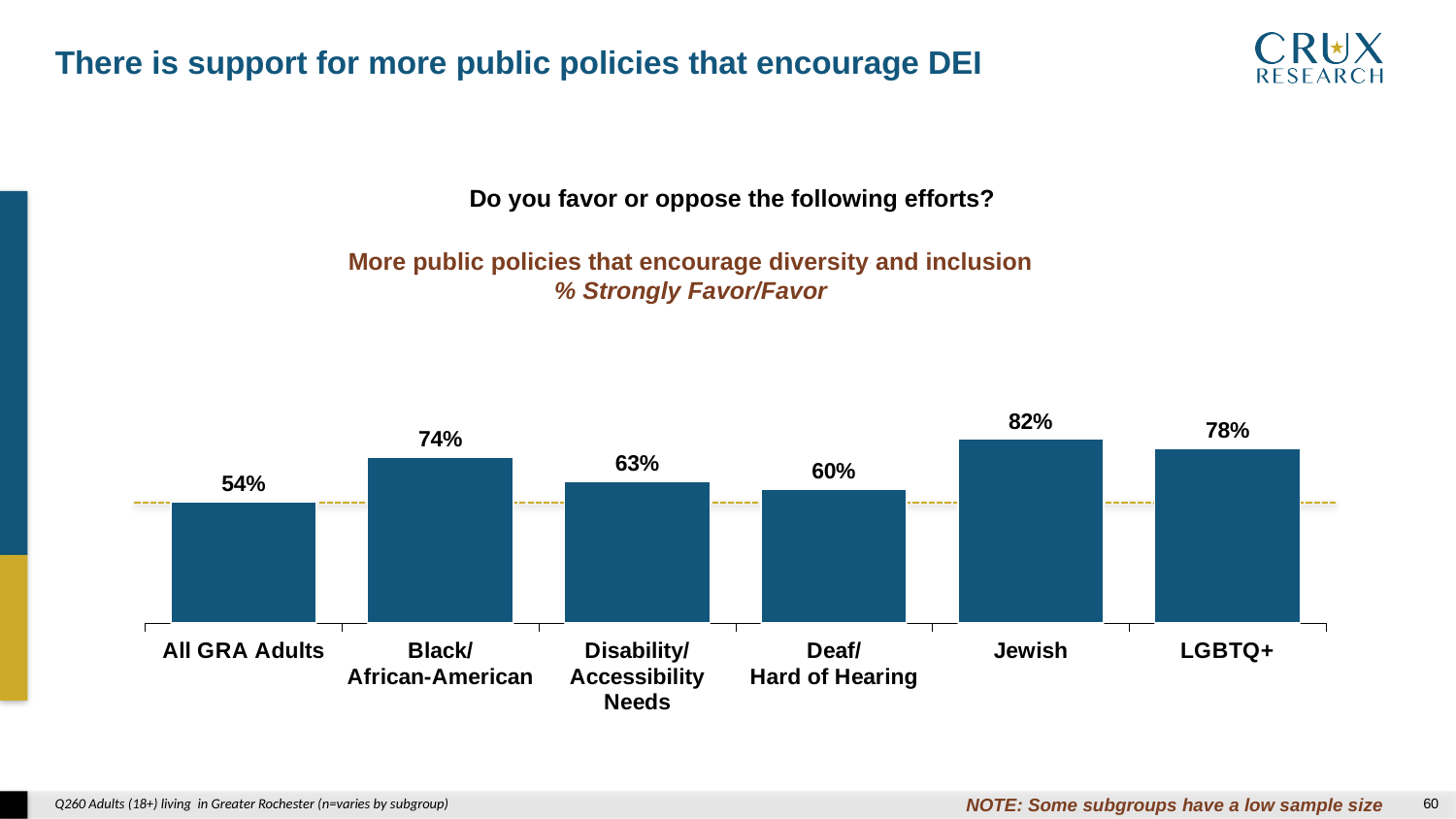
What percentage of All GRA Adults strongly favor/favor more public policies that encourage diversity and inclusion? 54% How many categories are shown on the chart? 6 What is the difference between the Black/African-American value and the All GRA Adults value? 20 percentage points What is the value shown for the Jewish subgroup? 82% Which subgroup has the highest percentage of strongly favor/favor? Jewish What is the value for the LGBTQ+ subgroup? 78% What is the difference between the Jewish and LGBTQ+ values? 4 percentage points What is the subtitle of the chart, shown in italics below the policy description? % Strongly Favor/Favor What percentage is shown for the Deaf/Hard of Hearing subgroup? 60% Which is larger, the value for Disability/Accessibility Needs or the value for Deaf/Hard of Hearing? Disability/Accessibility Needs What kind of chart is shown on the slide? Bar chart Which category has the lowest value on the chart? All GRA Adults